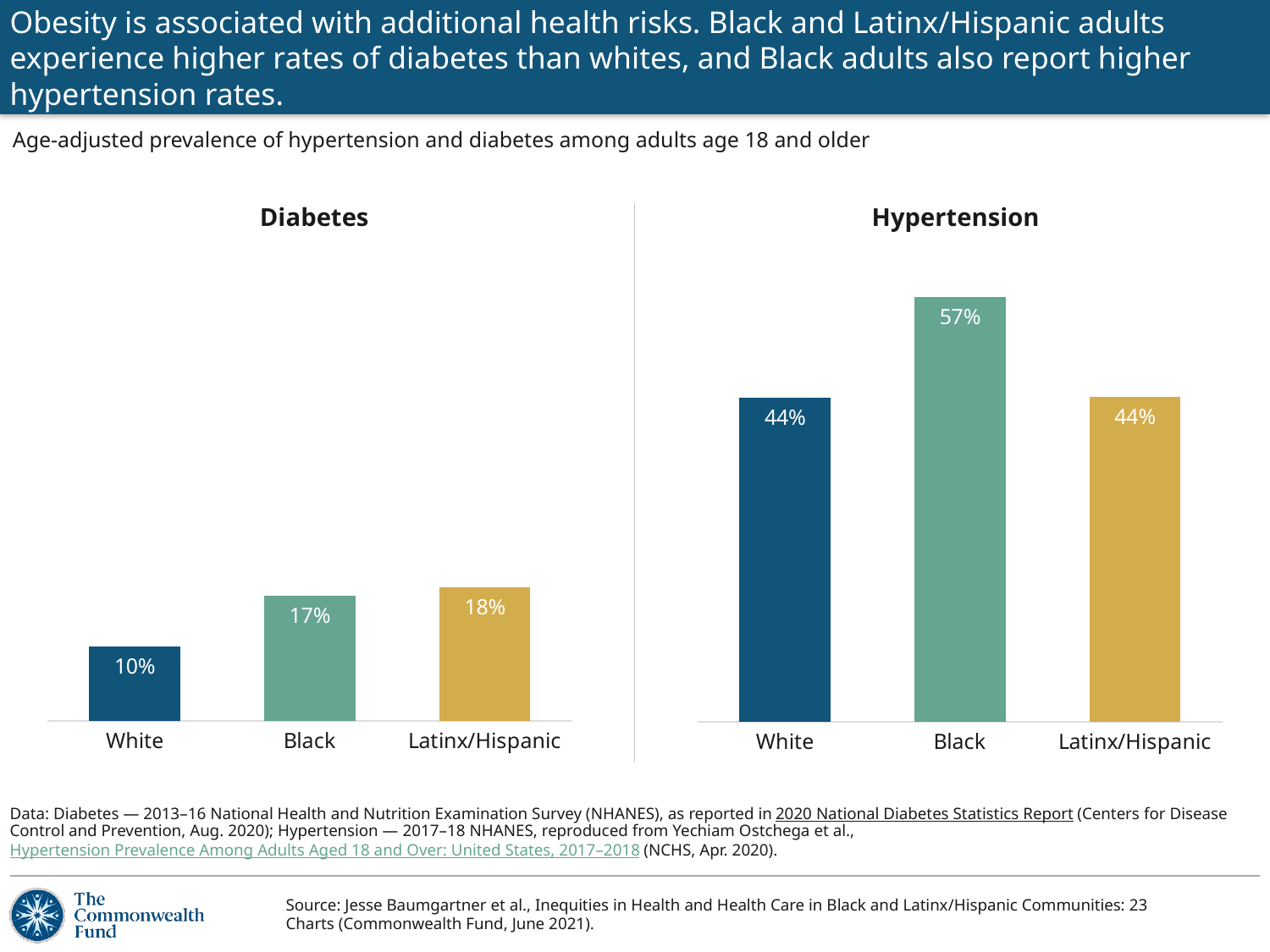
In the Diabetes chart, which group has the lowest value? White In the Hypertension chart, which group has the highest value? Black What kind of chart is the Diabetes chart? Bar chart In the Diabetes chart, what is the value for Latinx/Hispanic adults? 18% In the Hypertension chart, what is the difference between the values for Black and White adults? 13 percentage points How many groups are shown in the Hypertension chart? 3 In the Hypertension chart, what is the value for White adults? 44% In the Diabetes chart, what is the value for White adults? 10% In the Diabetes chart, which is larger, the value for Black adults or the value for White adults? Black In the Hypertension chart, what is the value for Black adults? 57% In the Diabetes chart, which group has the highest value? Latinx/Hispanic In the Diabetes chart, what is the difference between the values for Black and White adults? 7 percentage points